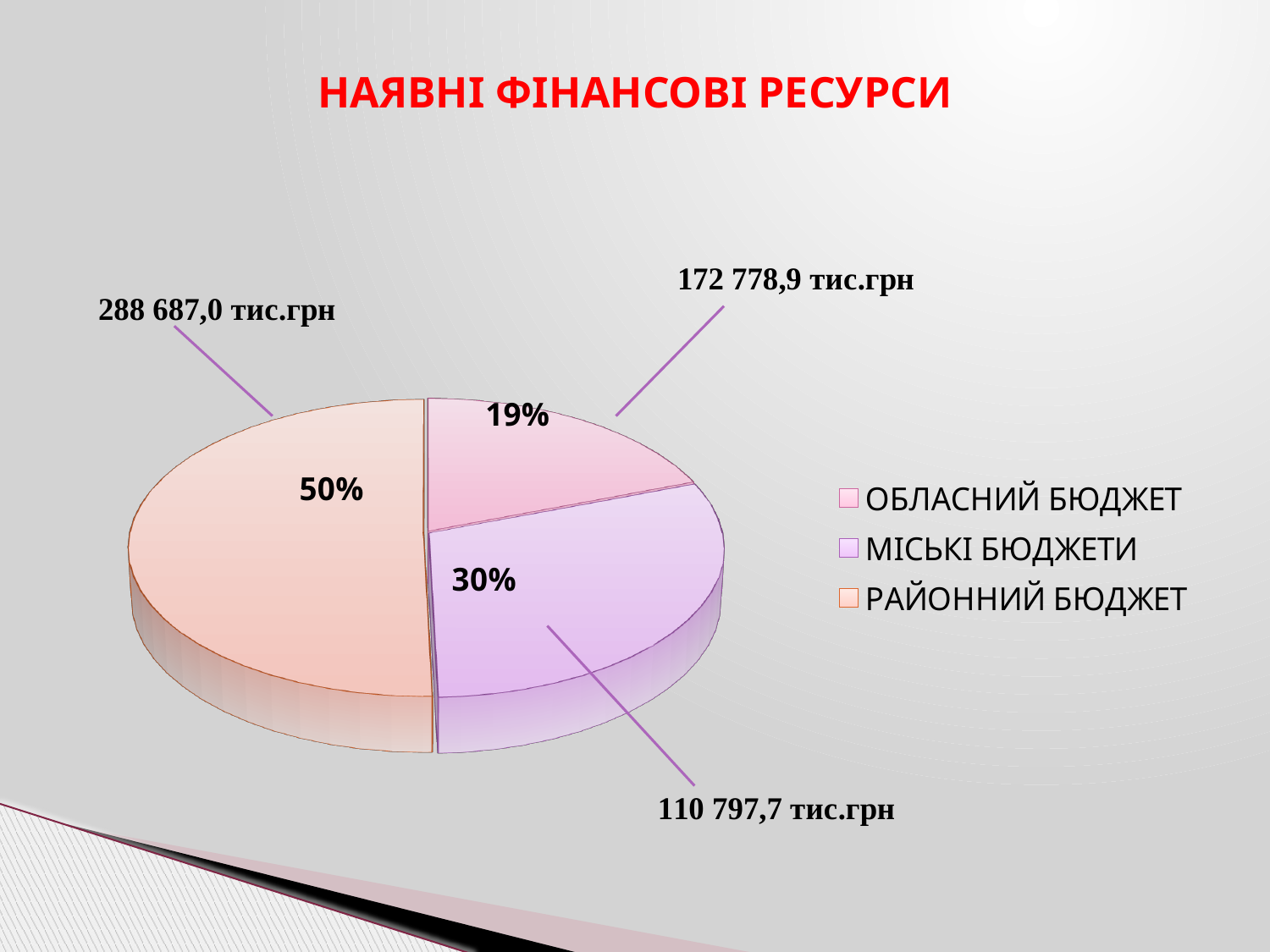
How many slices does the pie chart have? 3 What kind of chart is shown on the slide? pie chart Which slice is larger: МІСЬКІ БЮДЖЕТИ or ОБЛАСНИЙ БЮДЖЕТ? МІСЬКІ БЮДЖЕТИ What share of the pie does РАЙОННИЙ БЮДЖЕТ represent? 50% What amount in тис.грн is shown for the РАЙОННИЙ БЮДЖЕТ slice? 288 687,0 тис.грн Which category has the largest slice of the pie? РАЙОННИЙ БЮДЖЕТ What share of the pie does ОБЛАСНИЙ БЮДЖЕТ represent? 19% What is the title of the chart on the slide? НАЯВНІ ФІНАНСОВІ РЕСУРСИ How many categories does the legend of the pie chart list? 3 What share of the pie does МІСЬКІ БЮДЖЕТИ represent? 30% What colour is the РАЙОННИЙ БЮДЖЕТ slice in the pie chart? peach (light orange) Which category has the smallest slice of the pie? ОБЛАСНИЙ БЮДЖЕТ